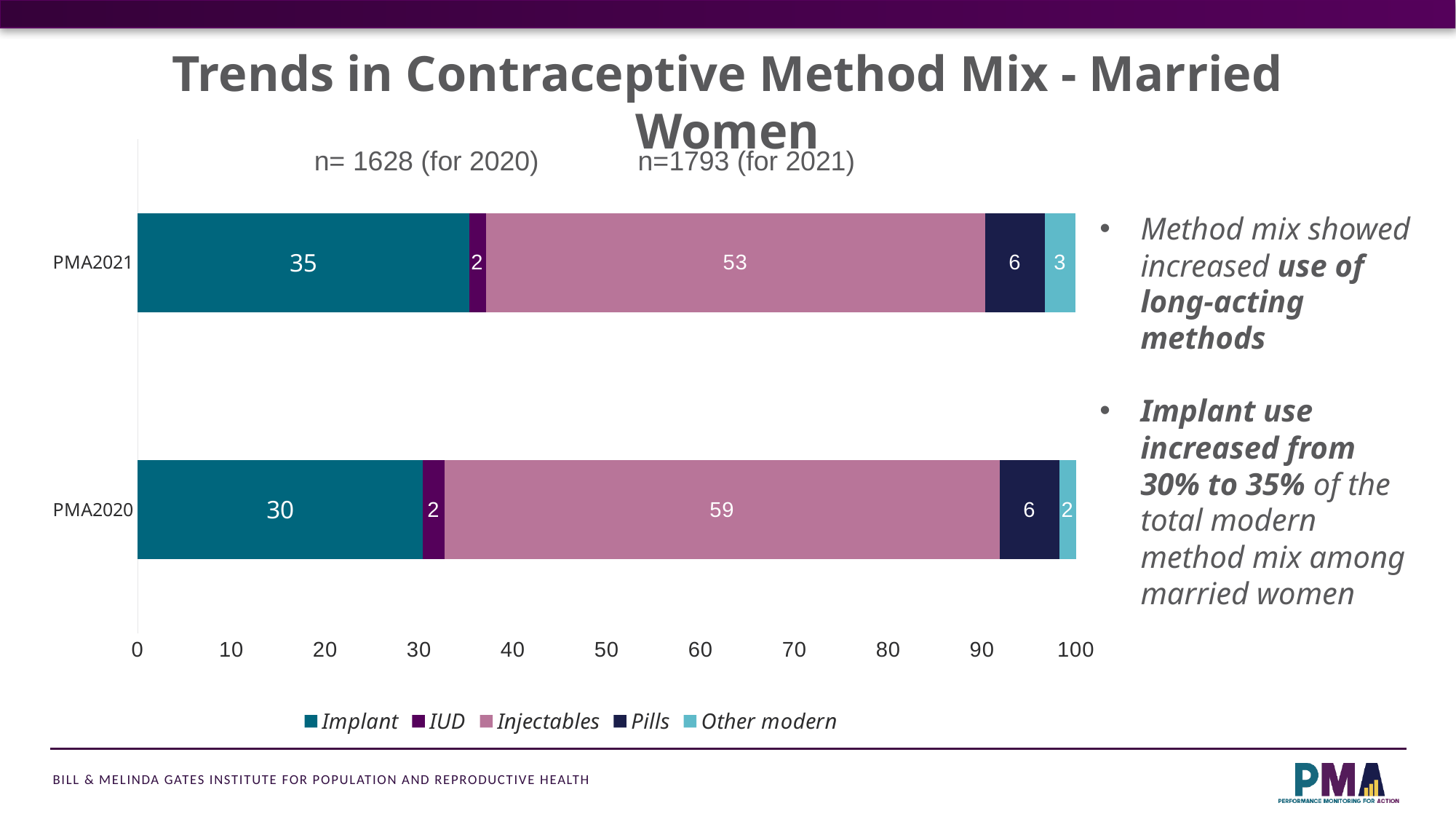
What is the Pills value for PMA2021? 6 What is the difference between the Injectables values for PMA2020 and PMA2021? 6 What is the total of the PMA2021 stacked bar? 99 What is the title of the chart? Trends in Contraceptive Method Mix - Married Women How many series does the legend list? 5 What is the Other modern value for PMA2020? 2 Which is larger, the Implant value for PMA2021 or for PMA2020? PMA2021 What is the Injectables value for PMA2020? 59 Which series has the largest value in the PMA2021 bar? Injectables What is the Implant value for PMA2021? 35 How many categories (bars) are shown on the chart? 2 What kind of chart is shown on the slide? Stacked bar chart